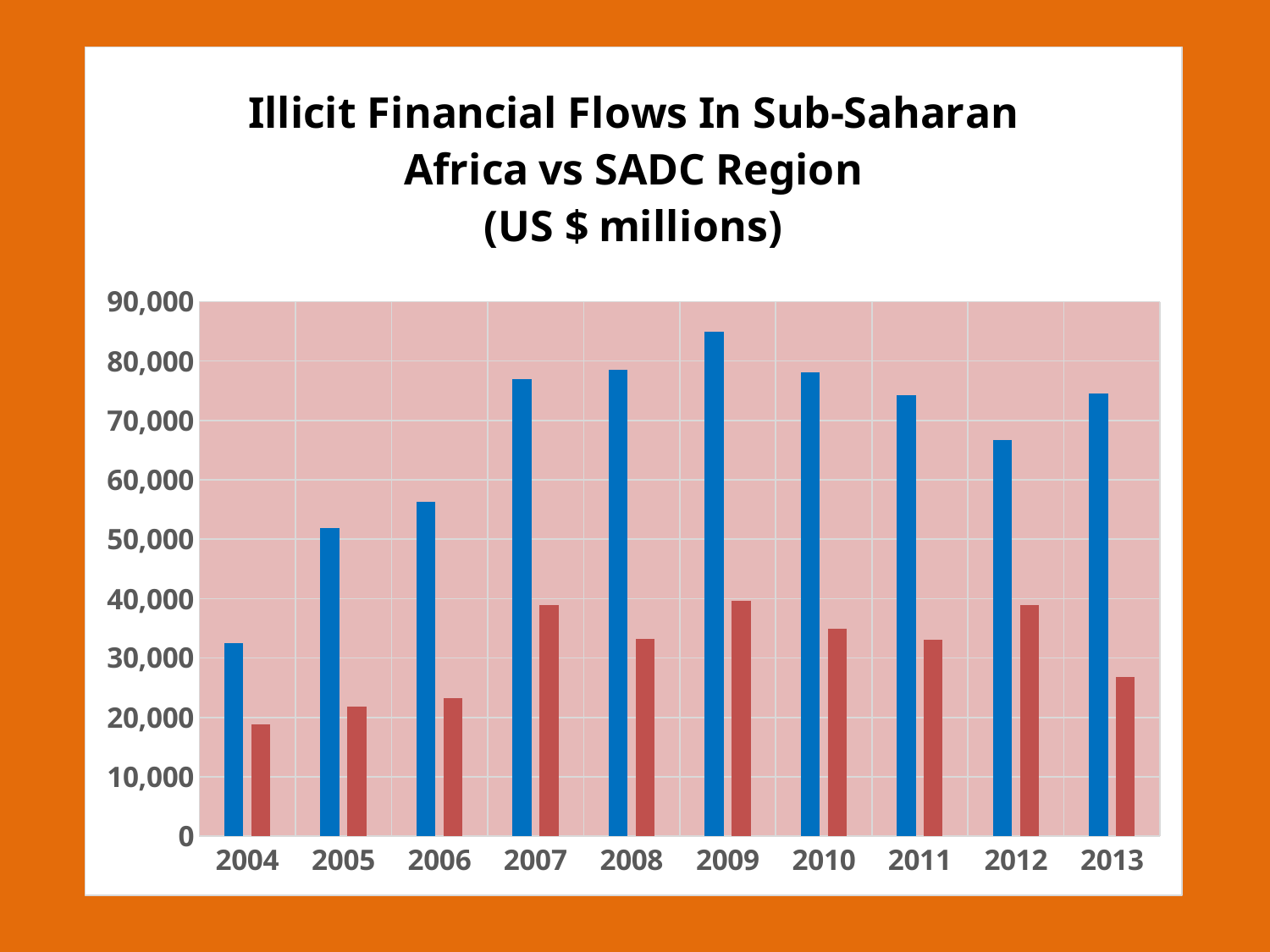
Is the value of the red bar for 2004 greater or less than 20,000? less Is the value of the red bar for 2013 greater or less than 30,000? less What is the title of the chart? Illicit Financial Flows In Sub-Saharan Africa vs SADC Region (US $ millions) Which is larger, the blue bar for 2007 or the blue bar for 2012? 2007 In which year is the red bar the shortest? 2004 In which year is the blue bar the tallest? 2009 What kind of chart is shown on the slide? bar chart Is the value of the blue bar for 2012 greater or less than 70,000? less Do the blue bars rise or fall from 2004 to 2009? rise How many years are shown on the x axis of the chart? 10 In which year is the blue bar the shortest? 2004